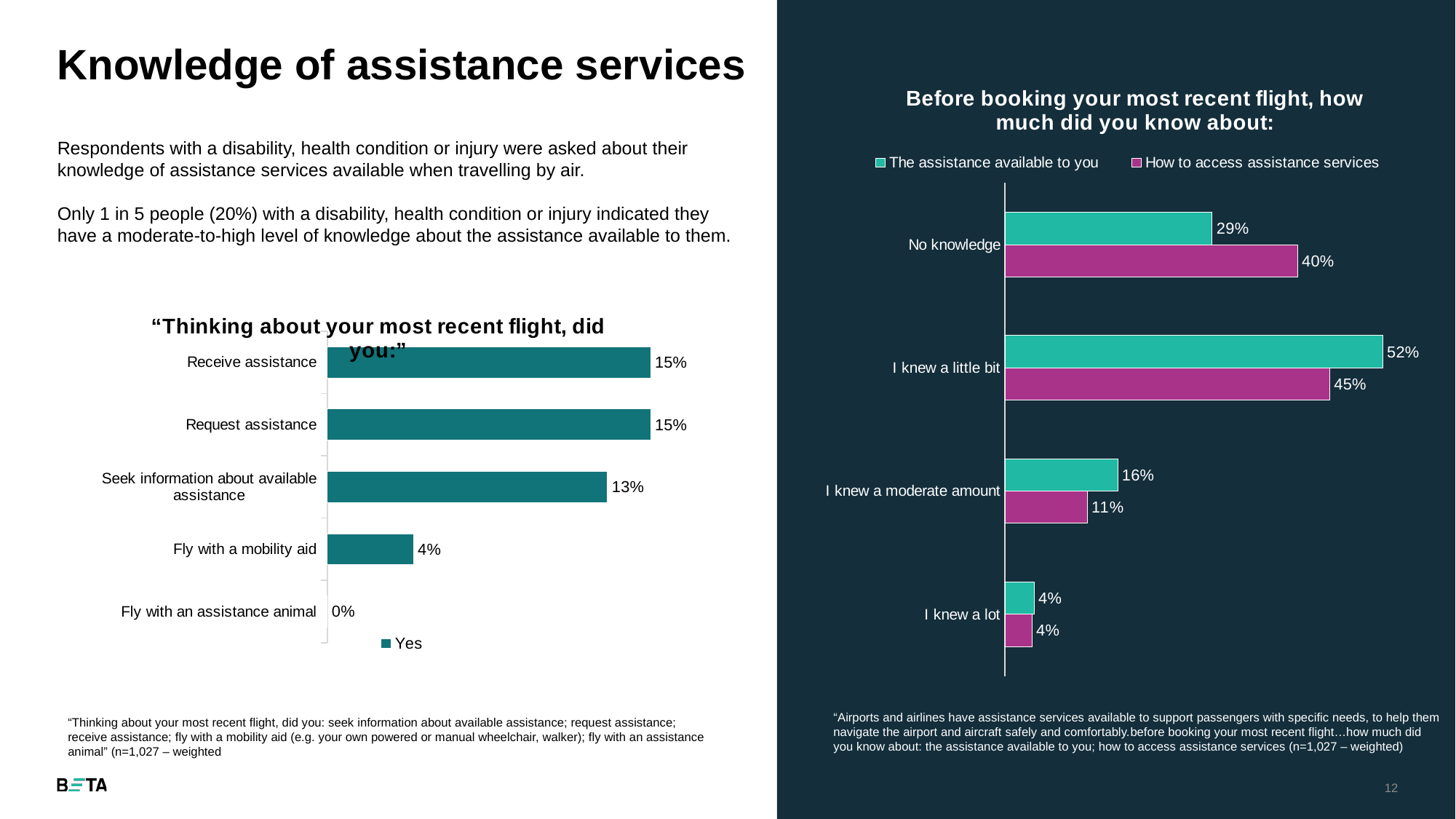
In the right chart titled "Before booking your most recent flight, how much did you know about:", how many series does the legend list? 2 In the left chart titled "Thinking about your most recent flight, did you:", what is the value for "Fly with a mobility aid"? 4% In the right chart titled "Before booking your most recent flight, how much did you know about:", which category has the highest value for the assistance available to you? I knew a little bit In the right chart titled "Before booking your most recent flight, how much did you know about:", what percentage had no knowledge of how to access assistance services? 40% In the left chart titled "Thinking about your most recent flight, did you:", what is the difference between "Seek information about available assistance" and "Fly with a mobility aid"? 9% What type of chart is the right chart titled "Before booking your most recent flight, how much did you know about:"? Bar chart In the left chart titled "Thinking about your most recent flight, did you:", which category has the lowest value? Fly with an assistance animal In the left chart titled "Thinking about your most recent flight, did you:", what percentage of respondents said they received assistance? 15% In the right chart titled "Before booking your most recent flight, how much did you know about:", for "I knew a moderate amount", which series is larger: the assistance available to you or how to access assistance services? The assistance available to you In the left chart titled "Thinking about your most recent flight, did you:", how many categories are shown? 5 In the right chart titled "Before booking your most recent flight, how much did you know about:", what is the difference between the two series for "No knowledge"? 11% In the right chart titled "Before booking your most recent flight, how much did you know about:", what is the value for "I knew a little bit" for the assistance available to you? 52%